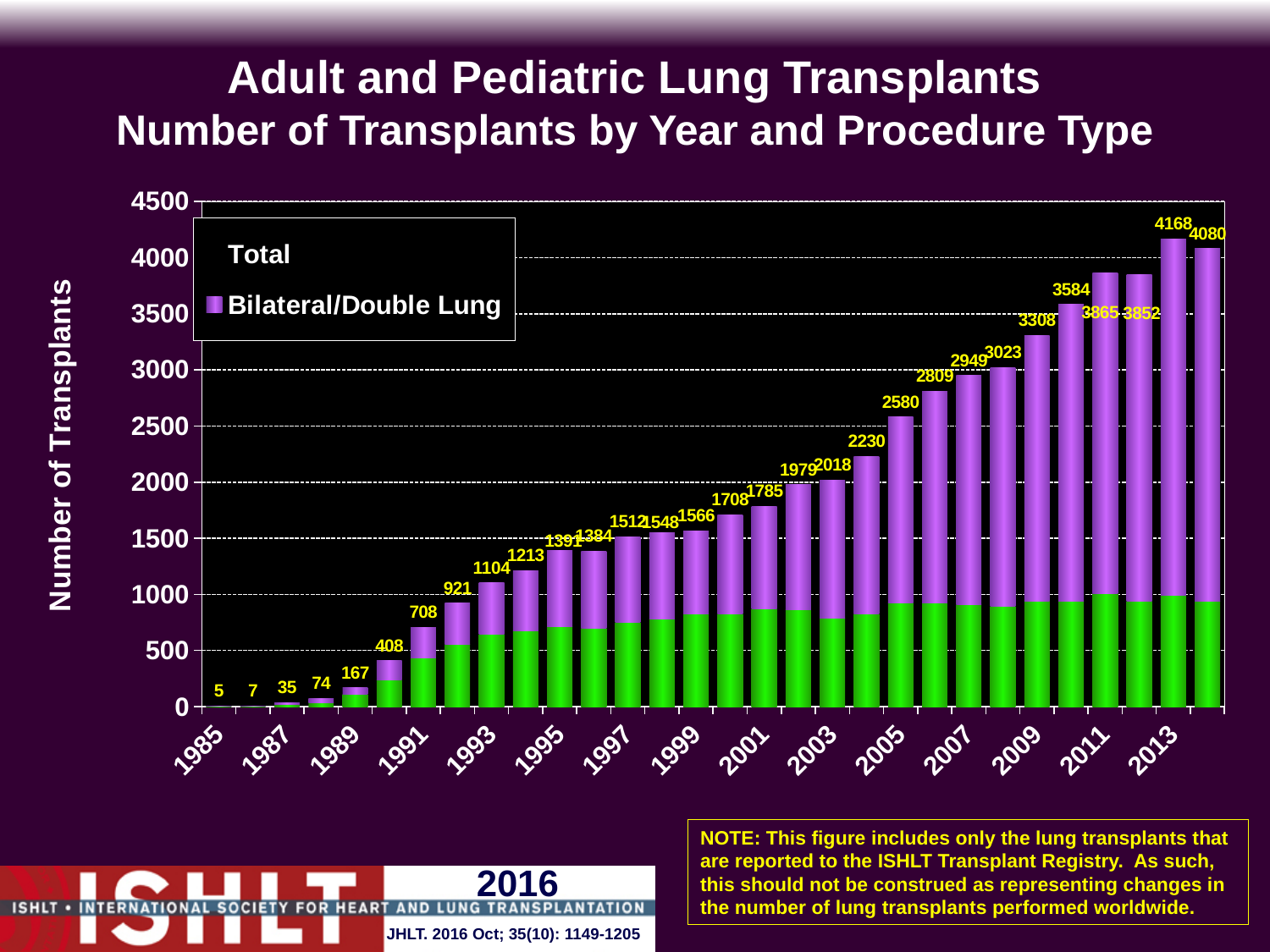
How many yearly bars are plotted in the chart? 30 Is the green (lower) segment of the 1991 bar greater or less than 500? less Which year has the highest total number of transplants? 2013 Which year has the lowest total number of transplants? 1985 What is the difference between the total for 2013 and the total for 2011? 303 Do the total numbers of transplants generally rise or fall from 1985 to 2013? Rise What is the total number of lung transplants shown for 2013? 4168 What is the total number of transplants shown for 1997? 1512 What is the total number of transplants shown for 1991? 708 What kind of chart is shown on the slide? Stacked bar chart What is the total number of transplants shown for 2005? 2580 Which year has a larger total, 2009 or 2007? 2009